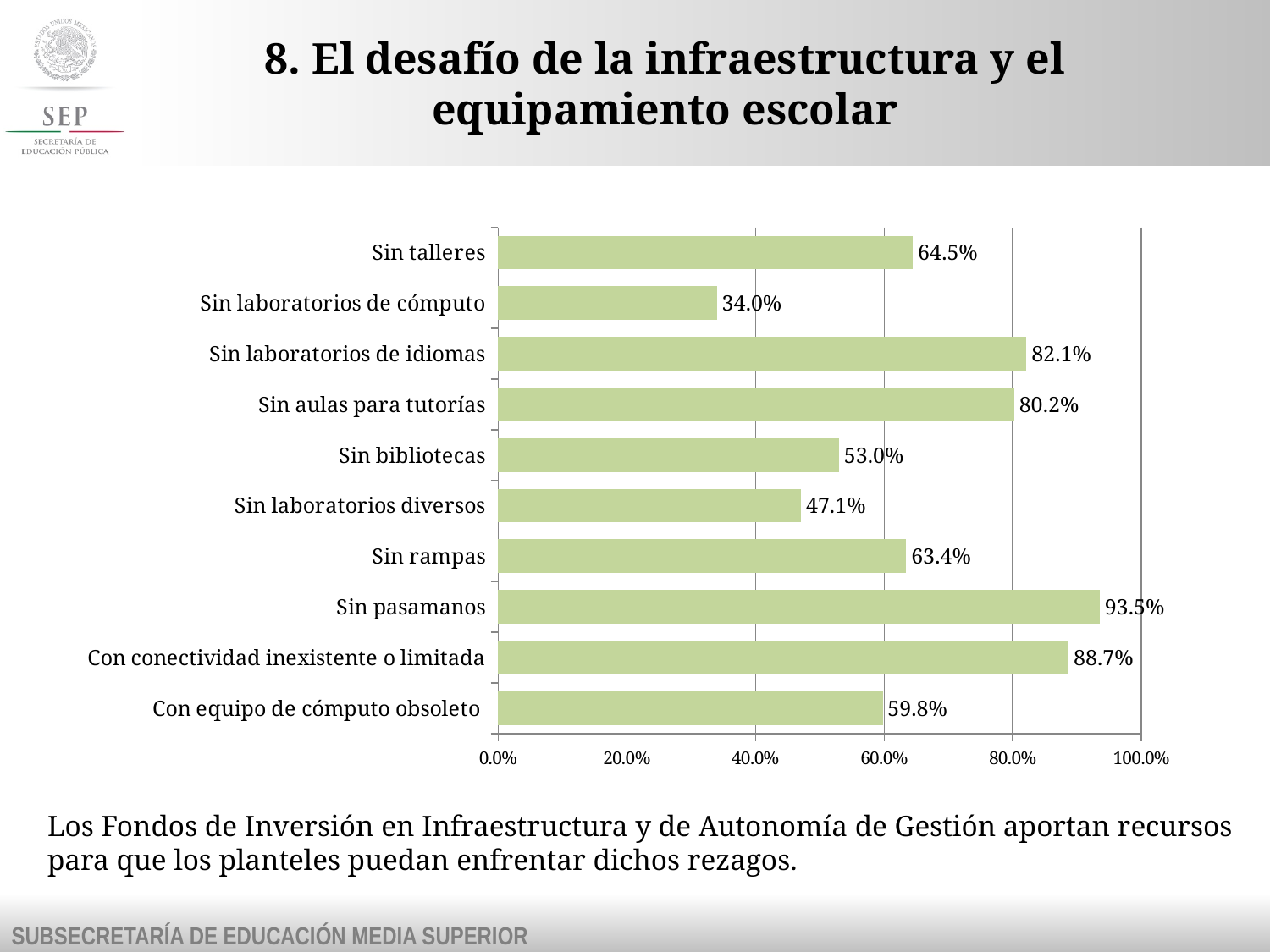
What kind of chart is shown on the slide? bar chart How many categories are shown in the chart? 10 What is the value for Sin bibliotecas? 53.0% What is the value for Con conectividad inexistente o limitada? 88.7% Which is larger, the value for Sin rampas or the value for Sin laboratorios diversos? Sin rampas What is the maximum value shown on the x axis? 100.0% What is the value for Sin talleres? 64.5% Which category has the lowest value? Sin laboratorios de cómputo Is the value for Con equipo de cómputo obsoleto greater or less than 60.0%? less What is the difference between the values for Sin laboratorios de idiomas and Sin aulas para tutorías? 1.9% Which category has the highest value? Sin pasamanos What is the difference between the values for Sin pasamanos and Sin laboratorios de cómputo? 59.5%